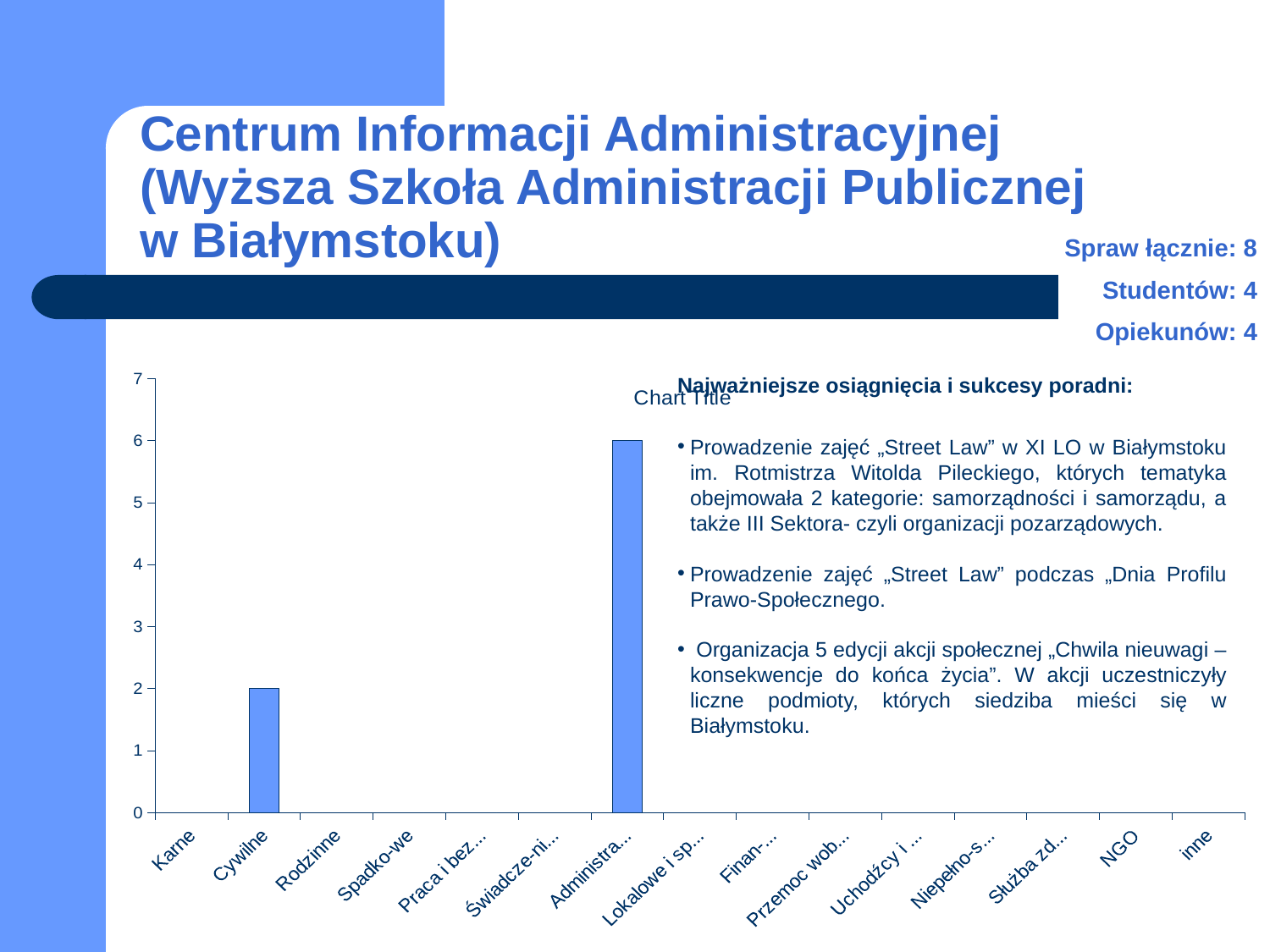
What is the value for Cywilne in the chart? 2 How many categories are shown on the x axis of the chart? 15 What is the value for Karne in the chart? 0 Is the value for Administra... greater or less than 5? greater What is the highest value shown on the y axis of the chart? 7 What is the value for Administra... in the chart? 6 Which is larger, the value for Cywilne or the value for Administra...? Administra... Which category has the highest bar in the chart? Administra... What is the difference between the values for Administra... and Cywilne? 4 What kind of chart is shown on the slide? bar chart Is the value for Cywilne greater or less than 3? less What is the title shown on the chart? Chart Title